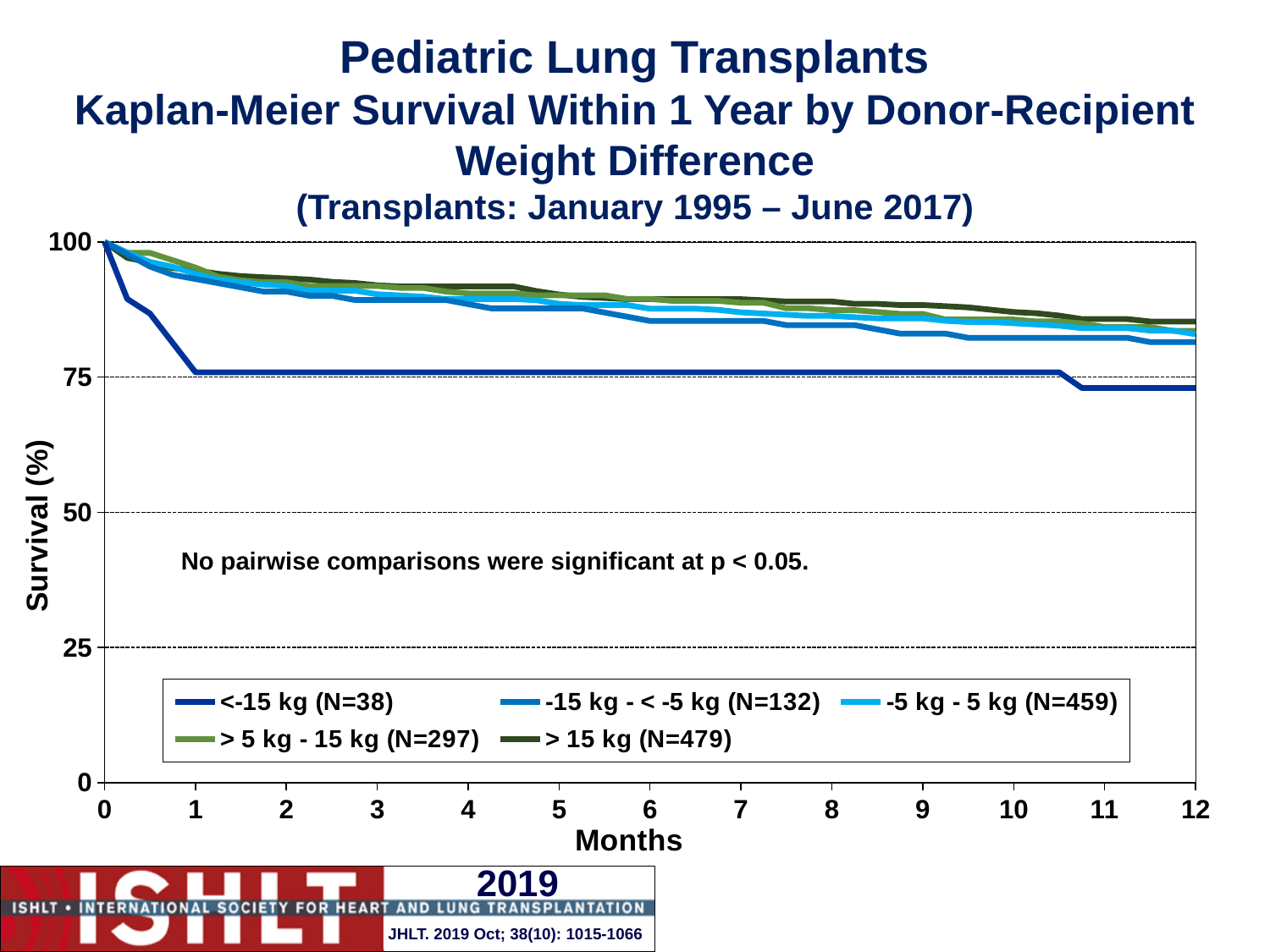
How many series does the legend list? 5 Is the survival value for the <-15 kg group at 2 months greater or less than 100? less Which group has the lowest survival at 12 months? <-15 kg (N=38) Is the survival value for the > 15 kg group at 12 months greater or less than 75? greater At 6 months, which is larger: the survival of the -15 kg - < -5 kg group or the <-15 kg group? -15 kg - < -5 kg What is the label of the y axis? Survival (%) Do the survival curves rise or fall as months increase? Fall What is the N for the -5 kg - 5 kg group shown in the legend? 459 Is the survival value for the -15 kg - < -5 kg group at 6 months greater or less than 75? greater At 12 months, which is larger: the survival of the <-15 kg group or the > 15 kg group? > 15 kg What kind of chart is shown on the slide? Line chart